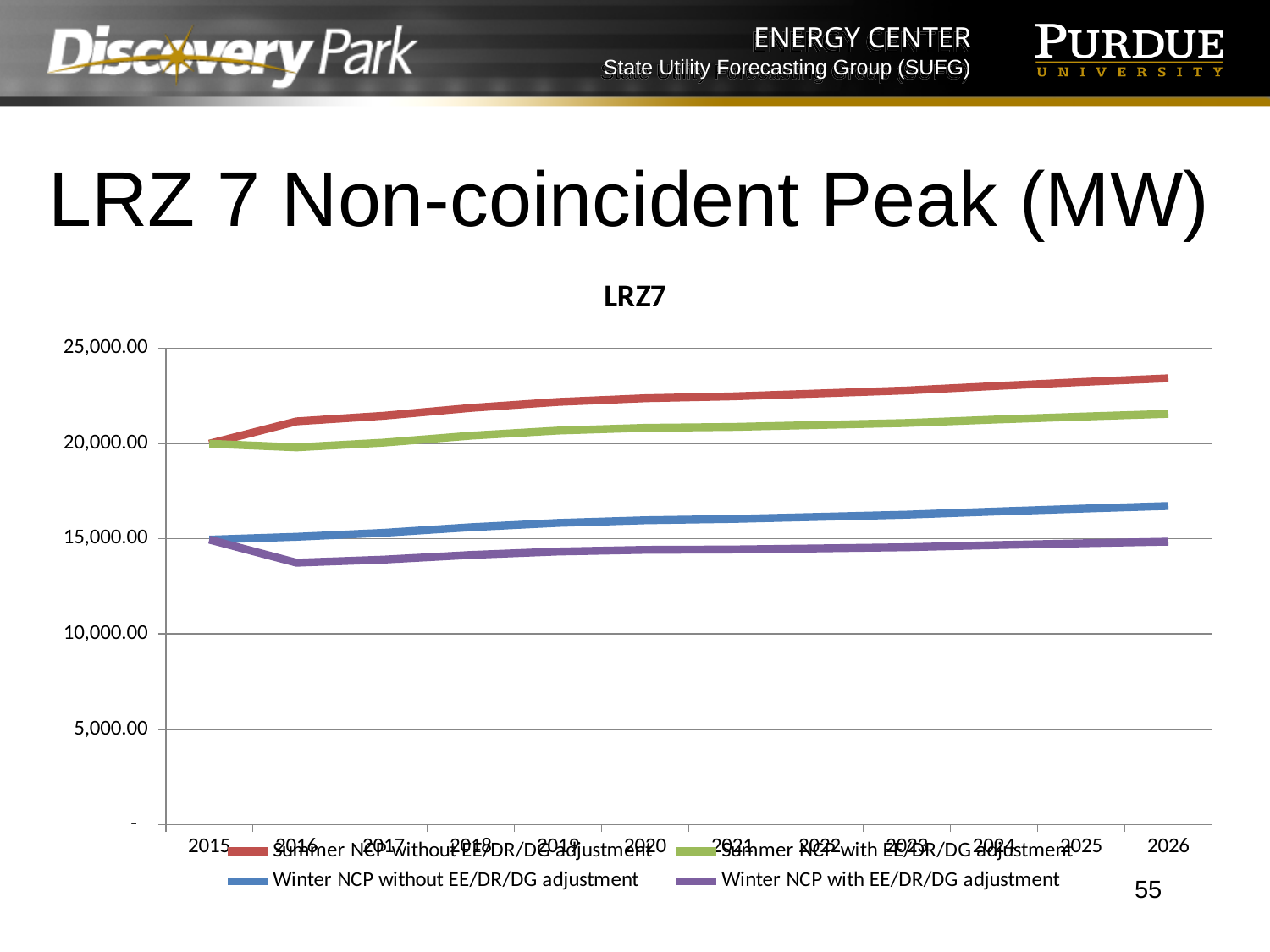
Which series is plotted with the red line? Summer NCP without EE/DR/DG adjustment In 2026, which is larger: Summer NCP without EE/DR/DG adjustment or Summer NCP with EE/DR/DG adjustment? Summer NCP without EE/DR/DG adjustment Which series has the highest values across the chart? Summer NCP without EE/DR/DG adjustment How many years are plotted along the x axis of the LRZ7 chart? 12 Does the Summer NCP without EE/DR/DG adjustment line rise or fall from 2015 to 2026? Rise Which series has the lowest values across the chart? Winter NCP with EE/DR/DG adjustment Is the value for Summer NCP without EE/DR/DG adjustment in 2026 greater or less than 20,000.00? greater Is the value for Winter NCP with EE/DR/DG adjustment in 2016 greater or less than 15,000.00? less What is the title printed above the chart? LRZ7 How many series does the legend of the LRZ7 chart list? 4 What kind of chart is shown on the slide? Line chart Is the value for Winter NCP without EE/DR/DG adjustment in 2026 greater or less than 15,000.00? greater